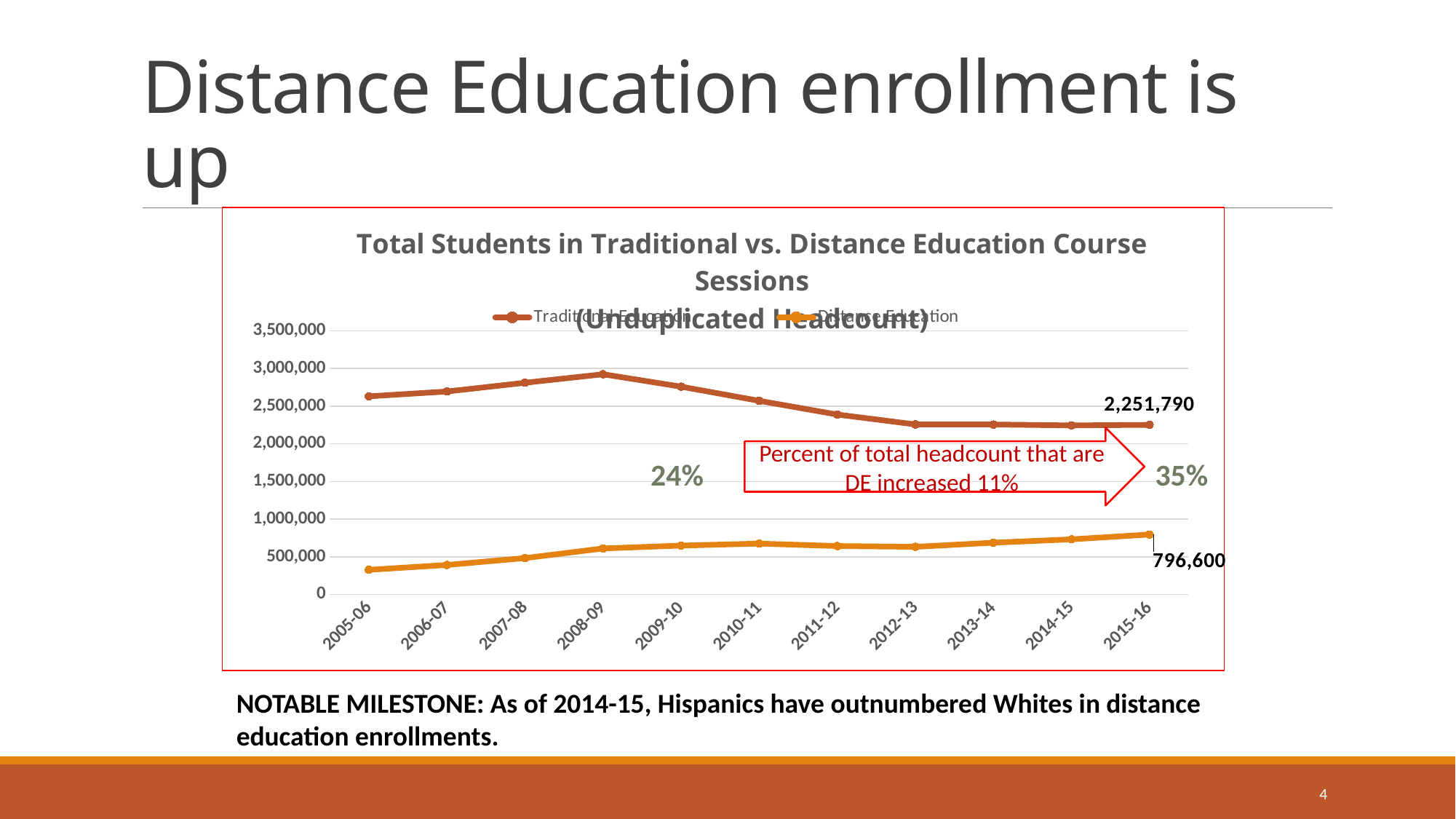
In 2015-16, which series has the larger value, Traditional Education or Distance Education? Traditional Education Is the value for Distance Education in 2005-06 greater or less than 500,000? less Does the Distance Education series generally rise or fall from 2005-06 to 2015-16? rise In which year does the Traditional Education series reach its highest value? 2008-09 What is the title of the chart? Total Students in Traditional vs. Distance Education Course Sessions (Unduplicated Headcount) What is the value for Distance Education in 2015-16? 796,600 How many academic years are plotted on the x axis? 11 In which year is the Distance Education series at its lowest? 2005-06 How many series does the legend list? 2 What is the value for Traditional Education in 2015-16? 2,251,790 What is the difference between the Traditional Education and Distance Education values in 2015-16? 1,455,190 What kind of chart is shown on the slide? line chart